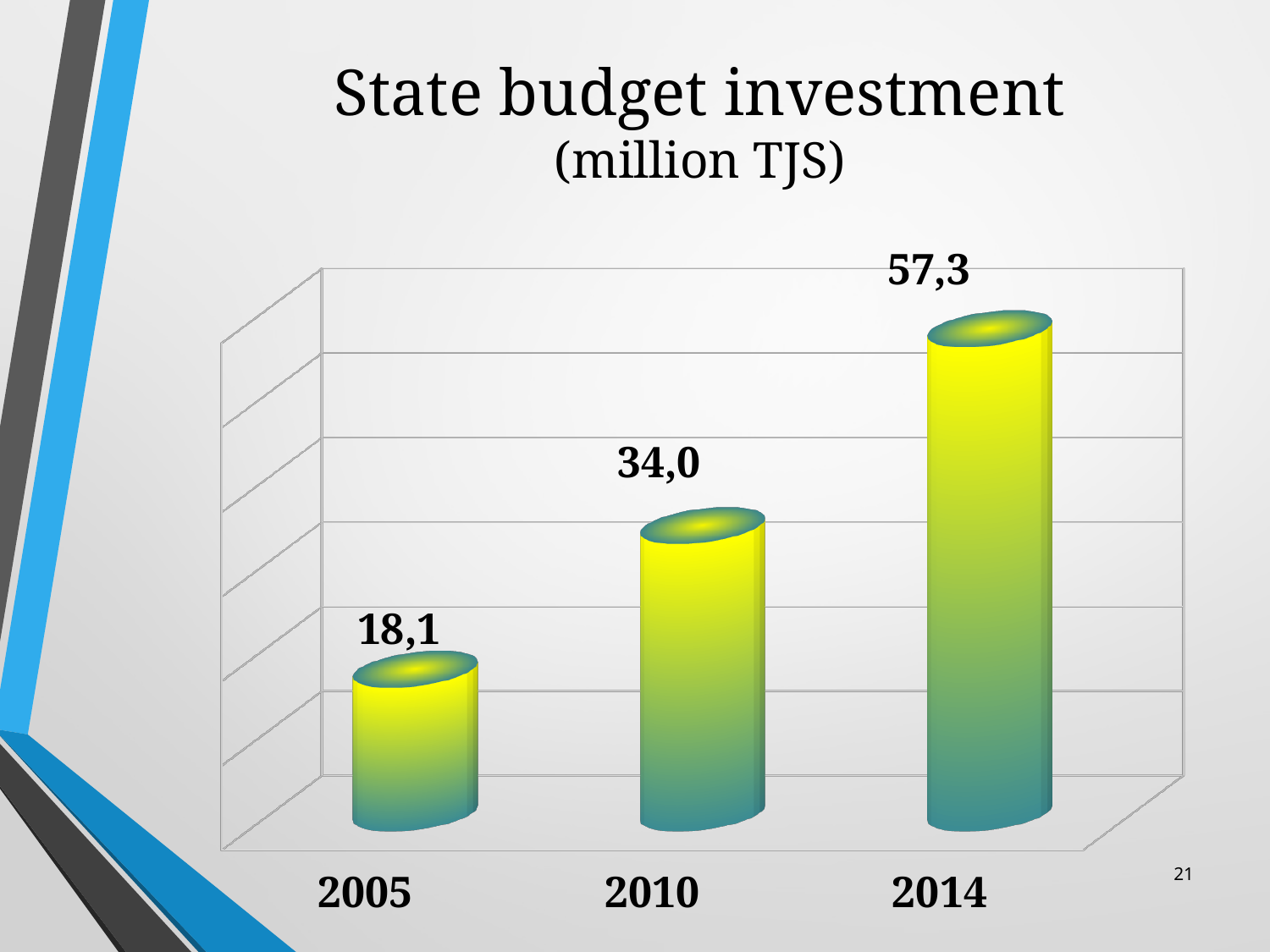
What unit is given in the chart title? million TJS What is the state budget investment value for 2014? 57,3 What is the state budget investment value for 2010? 34,0 What is the difference between the values for 2014 and 2005? 39,2 What is the difference between the values for 2010 and 2005? 15,9 Do the values rise or fall from 2005 to 2014? rise Which is larger, the value for 2010 or the value for 2014? 2014 What is the state budget investment value for 2005? 18,1 How many years are shown on the chart? 3 Which year has the lowest state budget investment? 2005 Which year has the highest state budget investment? 2014 What kind of chart is shown on the slide? bar chart